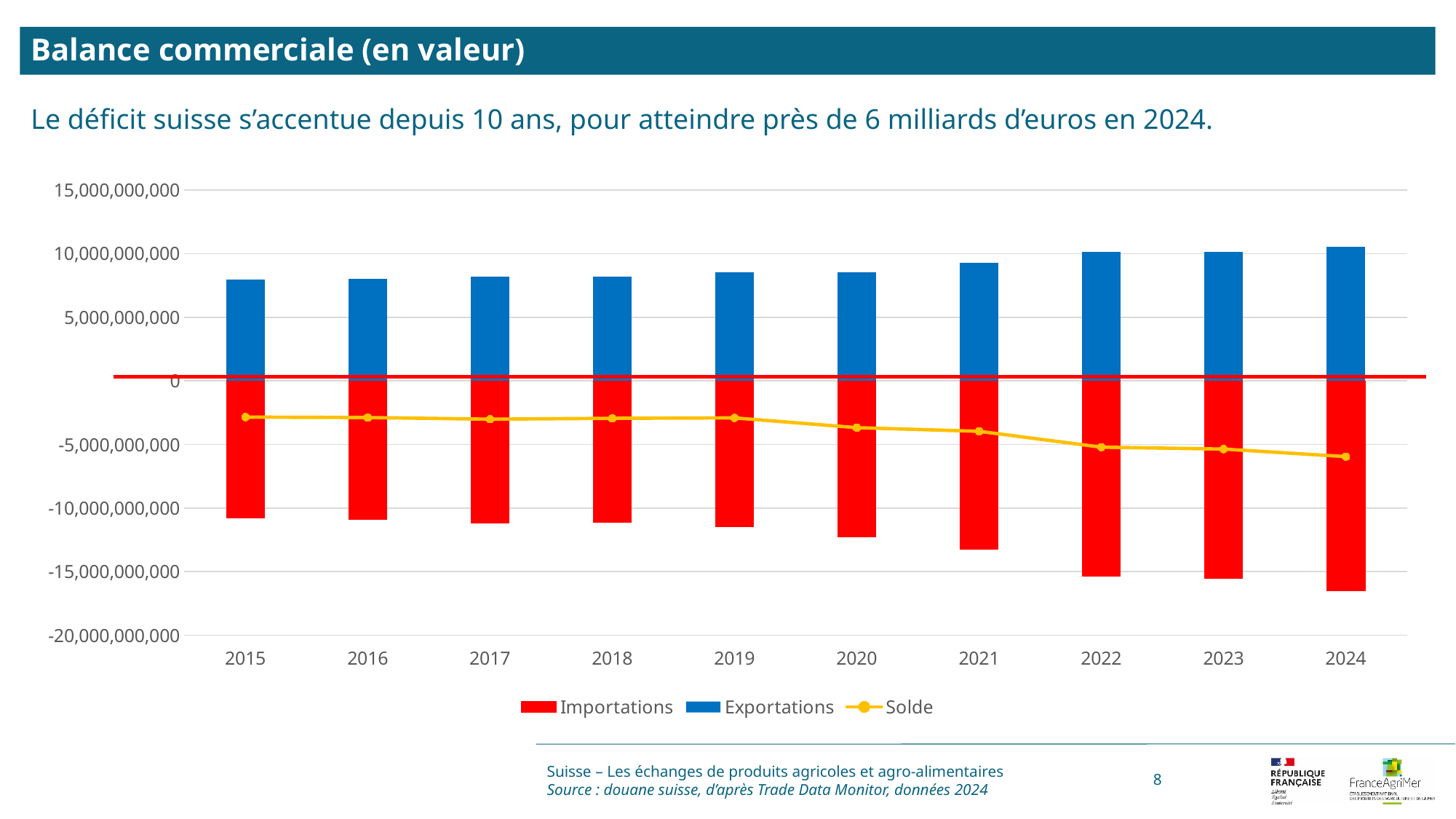
In which year does the Importations bar reach its lowest (most negative) value? 2024 What colour are the Importations bars? Red Is the Importations value for 2015 greater or less than -15,000,000,000? greater In which year is the Exportations bar the highest? 2024 Is the Exportations value for 2015 greater or less than 10,000,000,000? less Which series in the legend is drawn as a line with markers? Solde How many series does the chart legend list? 3 Is the Solde value for 2015 greater or less than -5,000,000,000? greater How many years are shown on the x axis of the chart? 10 Does the Solde line rise or fall from 2015 to 2024? Fall